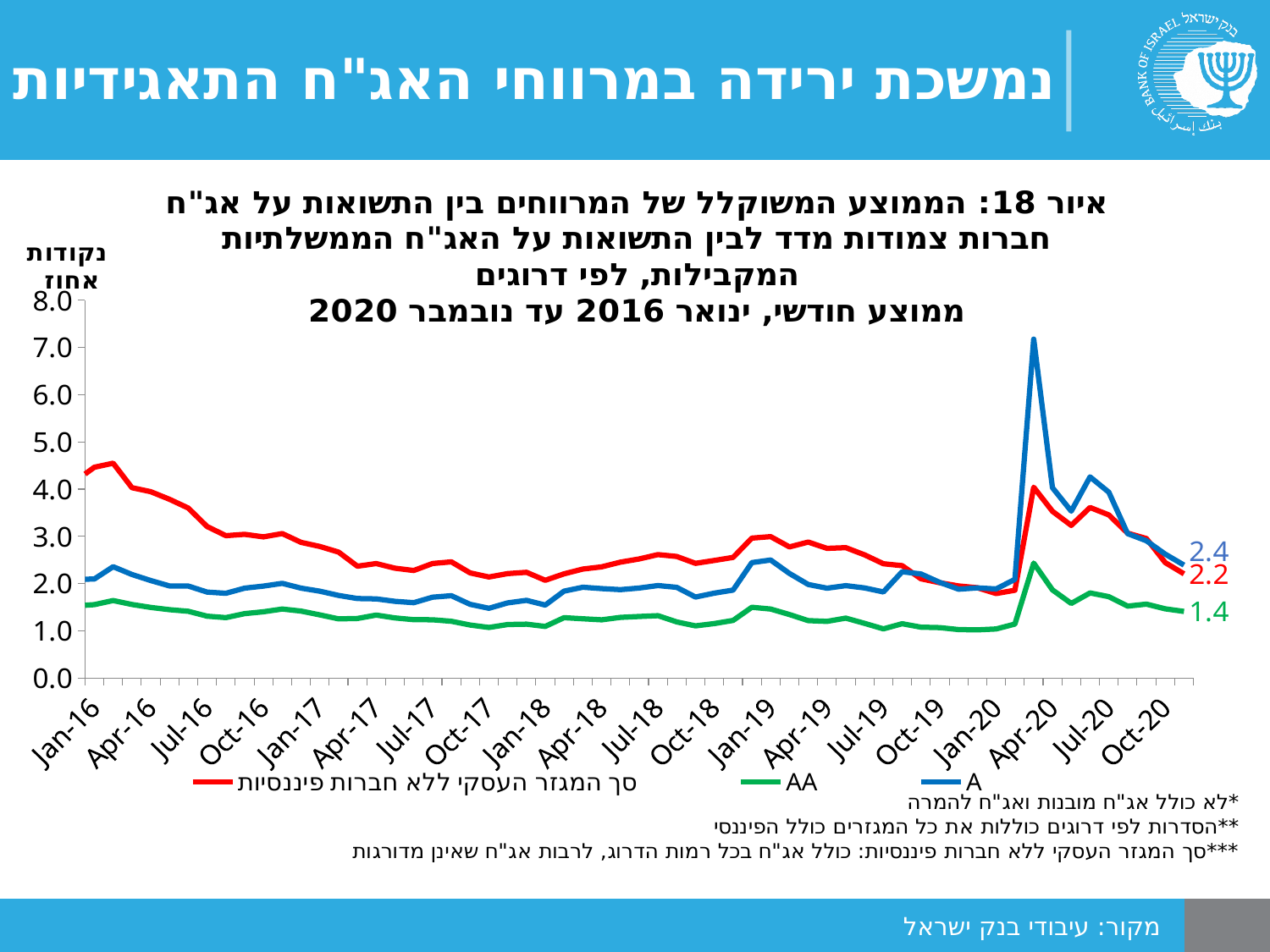
What is the value labelled at the end of the AA series (green line)? 1.4 Which series has the highest value at the end of the period? A Which series has the lowest value at the end of the period? AA How many series does the legend list? 3 Is the peak value of the A series around Apr-20 greater or less than 6.0? greater Is the value of the red series at Jan-16 greater or less than 4.0? greater What is the value labelled at the end of the red series (סך המגזר העסקי ללא חברות פיננסיות)? 2.2 What is the difference between the end-of-period values of the A series and the AA series? 1.0 What kind of chart is shown on the slide? line chart What colour is the line for the AA series? green What is the value labelled at the end of the A series (blue line)? 2.4 Does the red series rise or fall between Jan-16 and Jan-17? fall